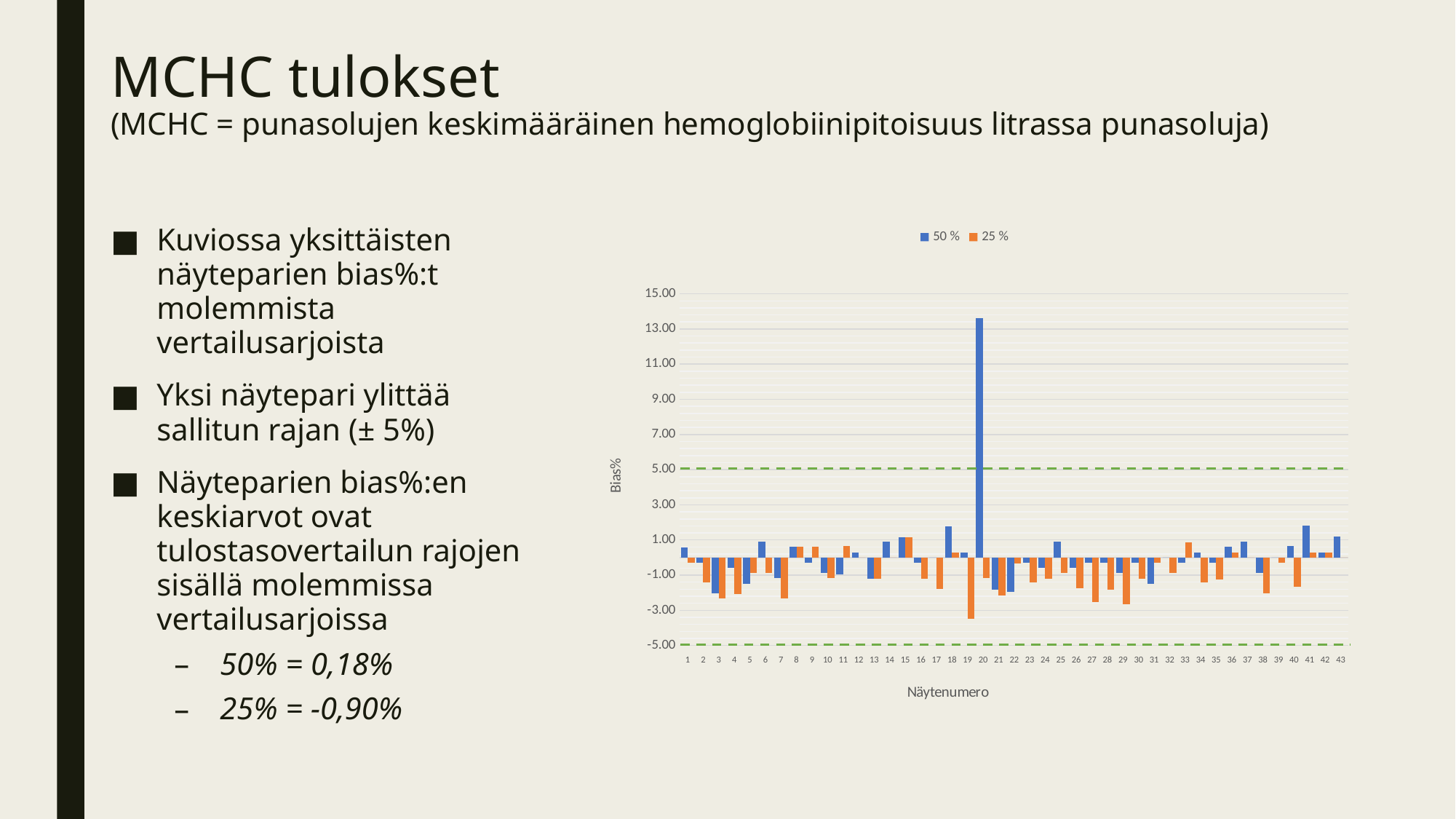
Is the 25 % series value for sample 19 greater or less than -3.00? less Which sample number has the lowest bias% value for the 25 % series? 19 What are the two series named in the chart legend? 50 % and 25 % Is the 50 % series value for sample 20 greater or less than 11.00? greater What kind of chart is shown on the slide? bar chart How many series does the chart legend list? 2 How many sample numbers (Näytenumero) are shown along the x axis of the chart? 43 Is the 25 % series value for sample 27 greater or less than -1.00? less For sample 20, which series has the larger bias% value, 50 % or 25 %? 50 % What is the label of the y axis of the chart? Bias% Which sample number has the highest bias% value for the 50 % series? 20